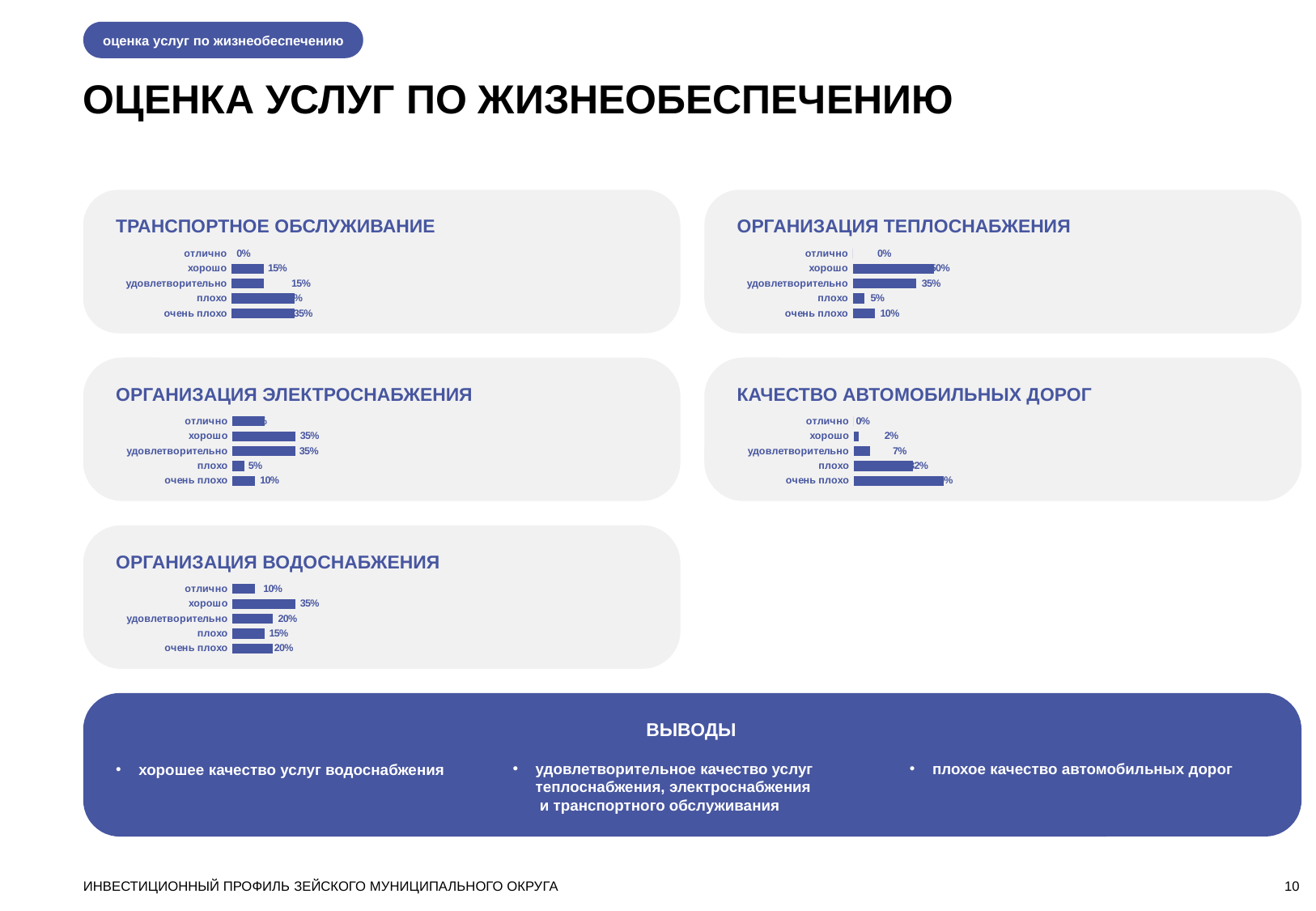
In the 'ОРГАНИЗАЦИЯ ВОДОСНАБЖЕНИЯ' chart, which category has the highest value? хорошо In the 'КАЧЕСТВО АВТОМОБИЛЬНЫХ ДОРОГ' chart, what is the value for 'удовлетворительно'? 7% In the 'ОРГАНИЗАЦИЯ ТЕПЛОСНАБЖЕНИЯ' chart, what is the value for 'плохо'? 5% In the 'ОРГАНИЗАЦИЯ ВОДОСНАБЖЕНИЯ' chart, what is the value for 'отлично'? 10% In the 'ОРГАНИЗАЦИЯ ЭЛЕКТРОСНАБЖЕНИЯ' chart, which is larger, 'хорошо' or 'плохо'? хорошо In the 'ОРГАНИЗАЦИЯ ТЕПЛОСНАБЖЕНИЯ' chart, what is the value for 'удовлетворительно'? 35% In the 'ОРГАНИЗАЦИЯ ЭЛЕКТРОСНАБЖЕНИЯ' chart, what is the value for 'очень плохо'? 10% In the 'ОРГАНИЗАЦИЯ ВОДОСНАБЖЕНИЯ' chart, what is the value for 'хорошо'? 35% How many categories does the 'КАЧЕСТВО АВТОМОБИЛЬНЫХ ДОРОГ' chart show? 5 In the 'ТРАНСПОРТНОЕ ОБСЛУЖИВАНИЕ' chart, what is the value for 'очень плохо'? 35% In the 'ТРАНСПОРТНОЕ ОБСЛУЖИВАНИЕ' chart, what is the value for 'отлично'? 0% In the 'ОРГАНИЗАЦИЯ ВОДОСНАБЖЕНИЯ' chart, what is the difference between 'хорошо' and 'плохо'? 20%